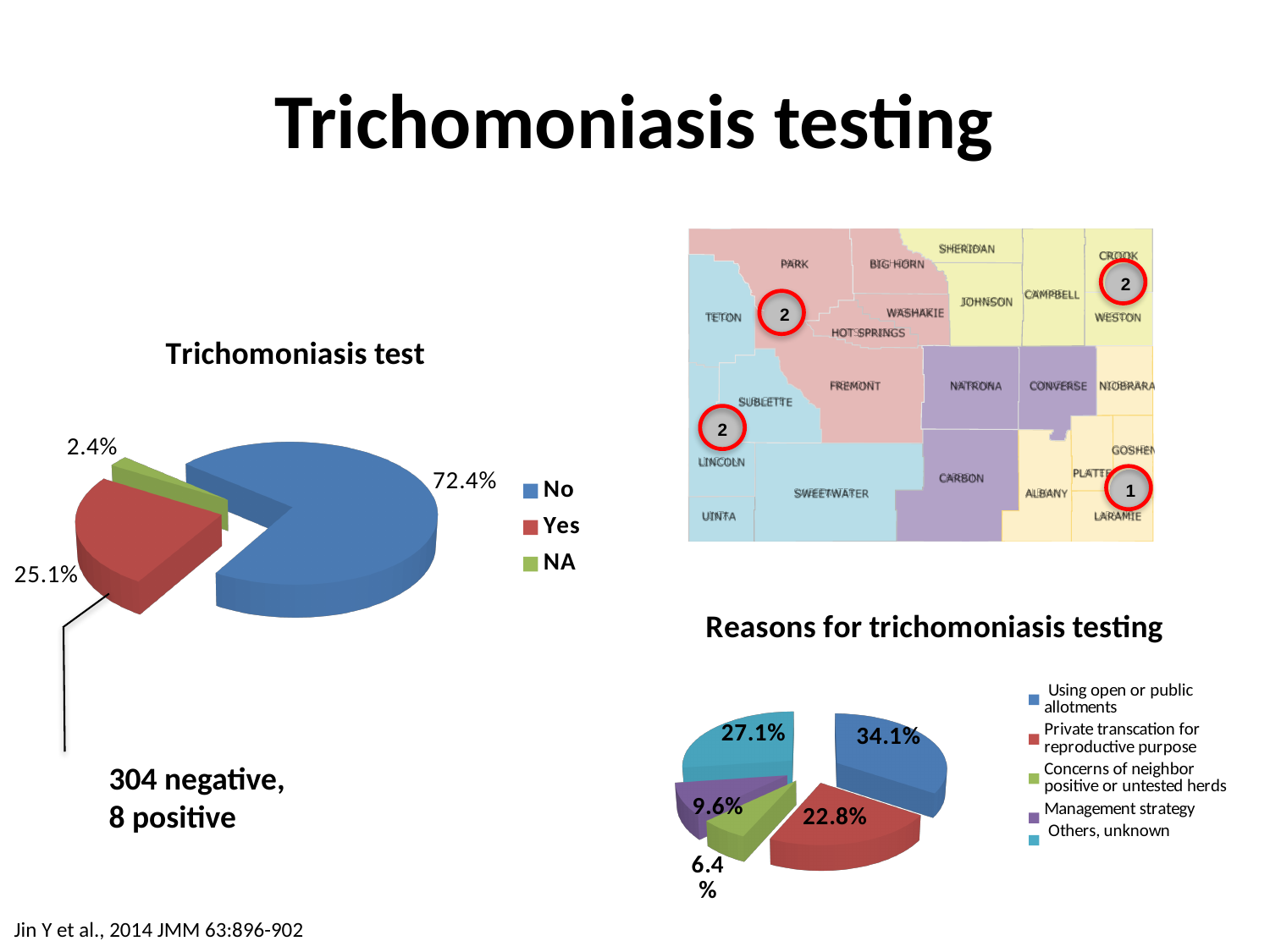
How many categories does the legend of the 'Trichomoniasis test' chart list? 3 In the 'Reasons for trichomoniasis testing' pie chart, what percentage corresponds to 'Using open or public allotments'? 34.1% In the 'Reasons for trichomoniasis testing' pie chart, which reason has the smallest share? Concerns of neighbor positive or untested herds In the 'Trichomoniasis test' pie chart, which category has the largest slice? No In the 'Reasons for trichomoniasis testing' pie chart, which is larger: 'Private transcation for reproductive purpose' or 'Others, unknown'? Others, unknown What type of chart is the 'Reasons for trichomoniasis testing' chart? Pie chart In the 'Reasons for trichomoniasis testing' pie chart, what percentage corresponds to 'Management strategy'? 9.6% In the 'Trichomoniasis test' pie chart, what is the share for 'NA'? 2.4% In the 'Trichomoniasis test' pie chart, what percentage of respondents answered 'Yes'? 25.1% In the 'Trichomoniasis test' pie chart, what percentage of respondents answered 'No'? 72.4% In the 'Trichomoniasis test' pie chart, what is the difference in percentage points between 'No' and 'Yes'? 47.3 In the 'Trichomoniasis test' pie chart, which category has the smallest slice? NA